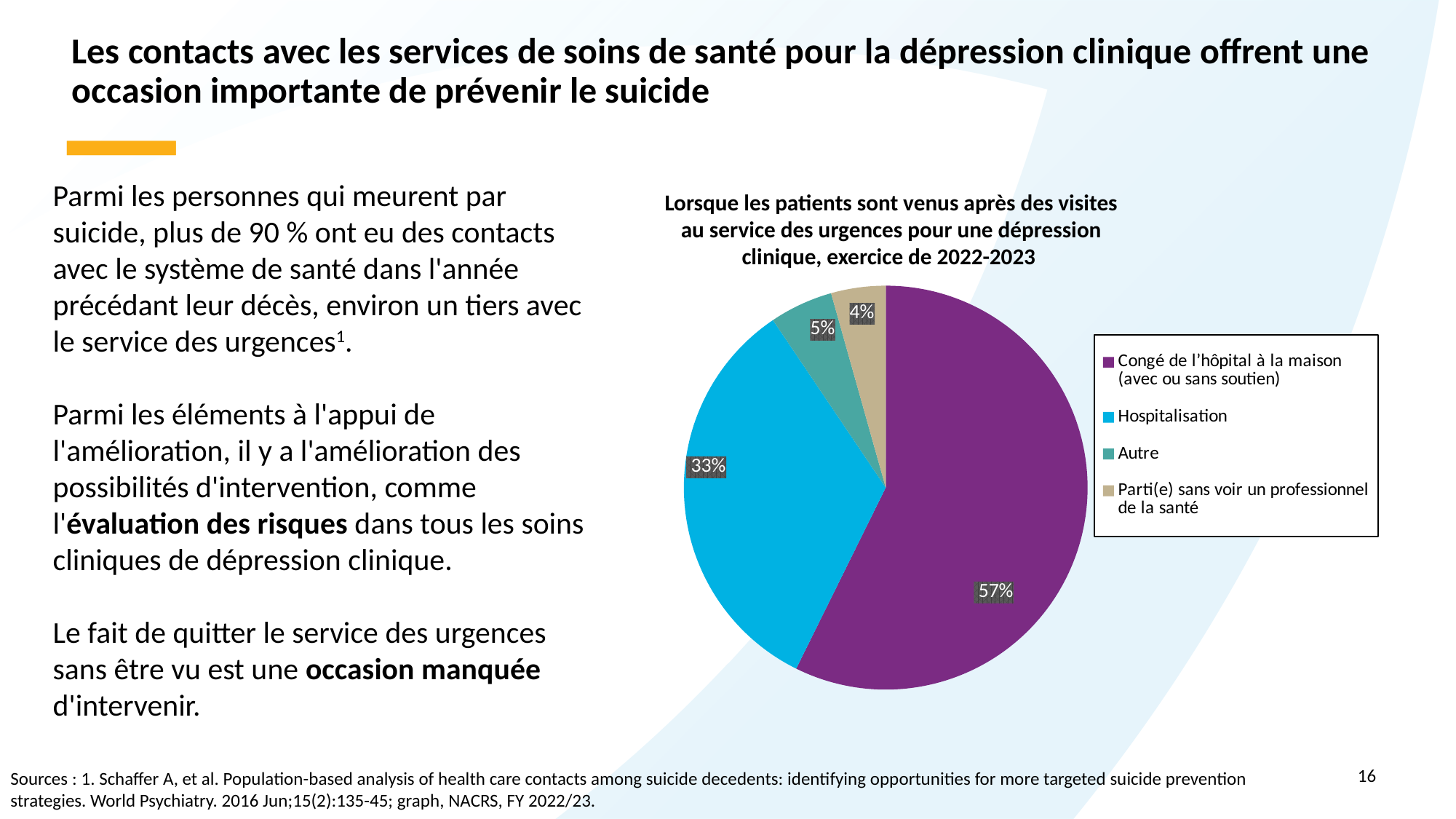
How many slices does the pie chart have? 4 What share of the pie is labelled "Hospitalisation"? 33% Which category has the smallest slice of the pie? Parti(e) sans voir un professionnel de la santé What is the title of the pie chart? Lorsque les patients sont venus après des visites au service des urgences pour une dépression clinique, exercice de 2022-2023 What share of the pie is labelled "Congé de l'hôpital à la maison (avec ou sans soutien)"? 57% What share of the pie is labelled "Parti(e) sans voir un professionnel de la santé"? 4% What is the difference in percentage points between "Congé de l'hôpital à la maison" and "Hospitalisation"? 24 What colour is the slice for "Hospitalisation"? blue Which category has the largest slice of the pie? Congé de l'hôpital à la maison (avec ou sans soutien) Which is larger: the share for "Hospitalisation" or the share for "Autre"? Hospitalisation What kind of chart is shown on the slide? pie chart What share of the pie is labelled "Autre"? 5%